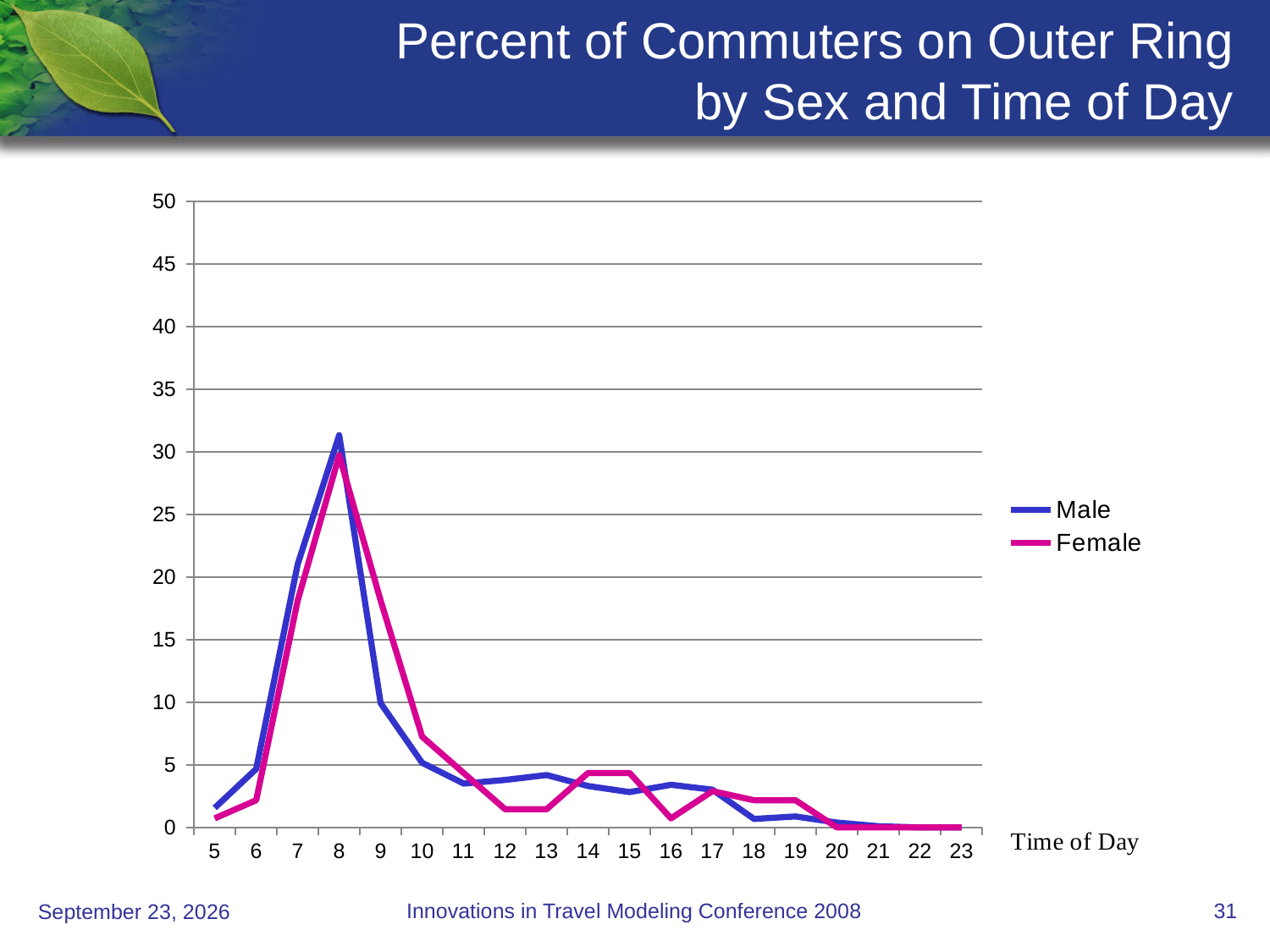
At which time of day does the Male line reach its highest value? 8 How many time-of-day points are plotted along the x axis? 19 Do the Male values rise or fall from time of day 8 to time of day 12? fall Is the Female value at time of day 12 greater or less than 5? less Is the Male value at time of day 8 greater or less than 25? greater Is the Female value at time of day 10 greater or less than 5? greater At which time of day does the Female line reach its highest value? 8 What kind of chart is shown on the slide? line chart At time of day 9, which series has the larger value, Male or Female? Female At time of day 16, which series has the larger value, Male or Female? Male How many series does the legend list? 2